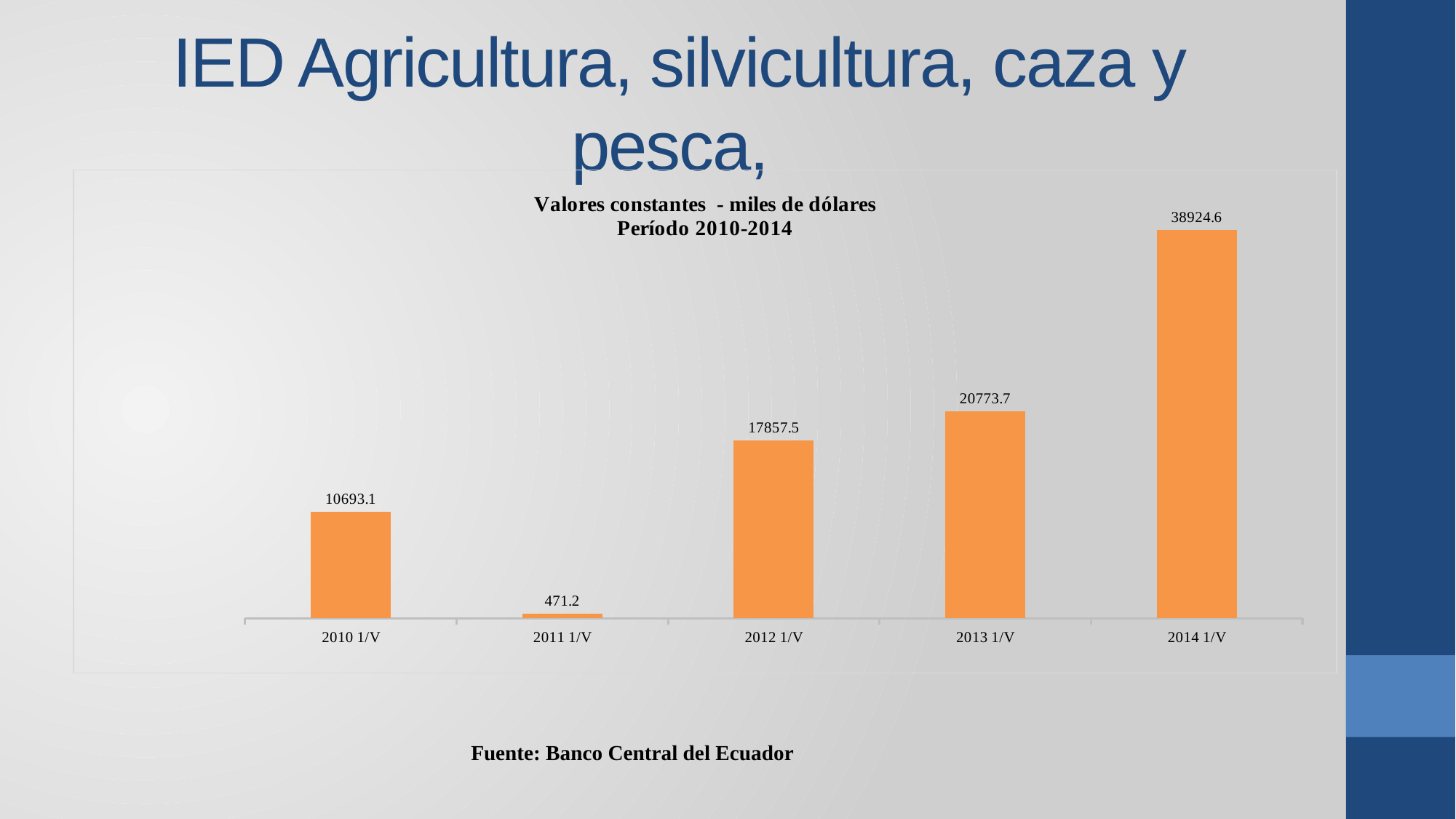
Which is larger, the value for 2010 1/V or the value for 2012 1/V? 2012 1/V What is the value for 2013 1/V? 20773.7 What is the value for 2011 1/V? 471.2 How many categories are shown on the x axis? 5 What is the value for 2012 1/V? 17857.5 What is the value for 2010 1/V? 10693.1 Which category has the lowest value? 2011 1/V What is the source cited below the chart? Banco Central del Ecuador What is the difference between the values for 2014 1/V and 2013 1/V? 18150.9 Which category has the highest value? 2014 1/V What kind of chart is shown on the slide? Bar chart What is the value for 2014 1/V? 38924.6